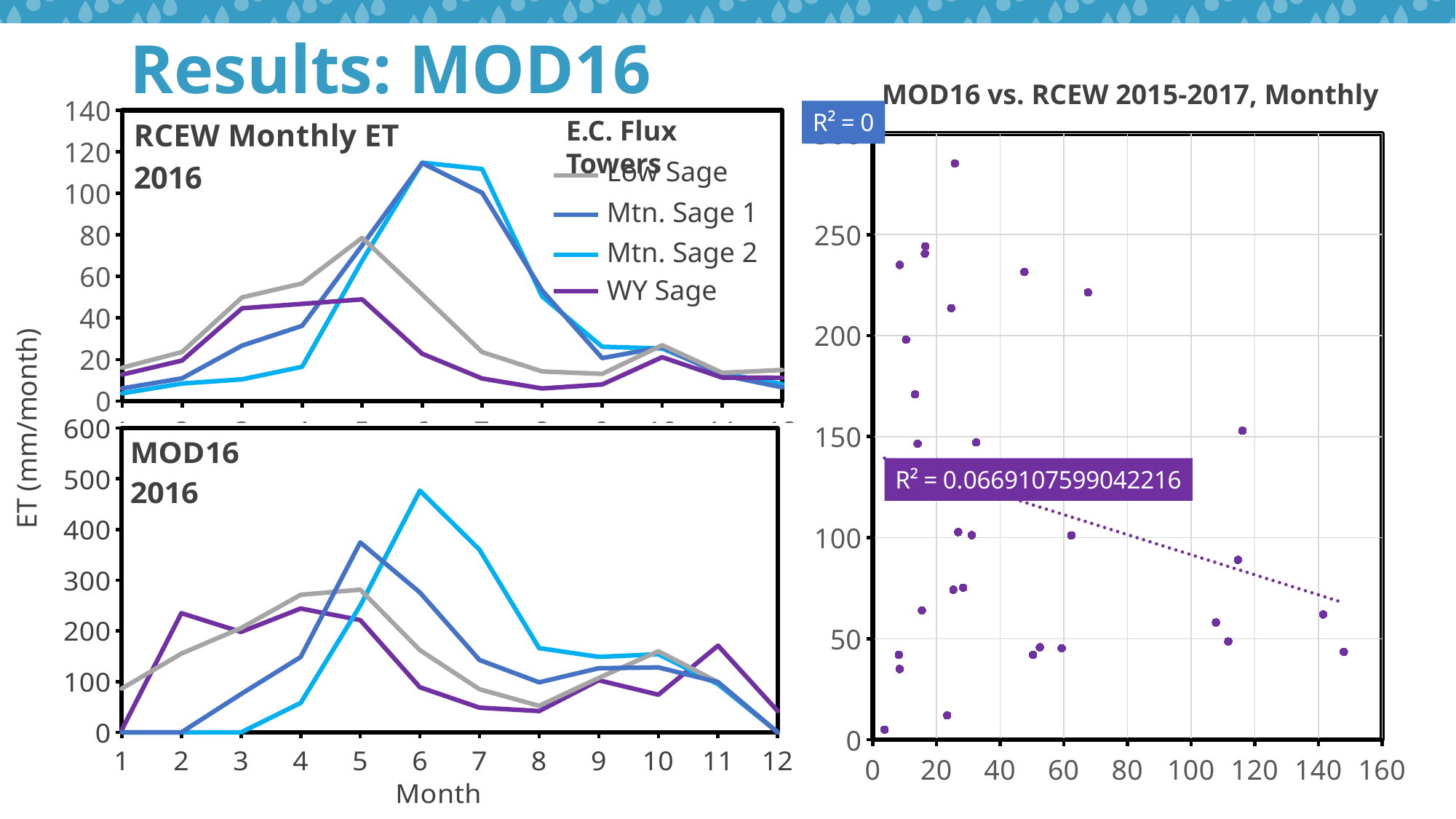
What kind of chart is the "RCEW Monthly ET 2016" chart? line chart What kind of chart is the "MOD16 vs. RCEW 2015-2017, Monthly" chart? scatter chart How many series does the E.C. Flux Towers legend list for the left-hand charts? 4 In the "RCEW Monthly ET 2016" chart, at month 5, which is larger: Low Sage or WY Sage? Low Sage In the "MOD16 2016" chart, which series reaches the highest peak value? Mtn. Sage 2 In the "RCEW Monthly ET 2016" chart, is the value for Low Sage at month 5 greater or less than 60? greater In the "MOD16 2016" chart, is the value for Mtn. Sage 1 at month 5 greater or less than 300? greater In the "RCEW Monthly ET 2016" chart, does the Mtn. Sage 2 line rise or fall from month 6 to month 9? fall In the "MOD16 2016" chart, is the value for Mtn. Sage 2 at month 6 greater or less than 400? greater What R² value is shown in the purple box on the "MOD16 vs. RCEW 2015-2017, Monthly" chart? R² = 0.0669107599042216 How many months are shown along the x axis of the "MOD16 2016" chart? 12